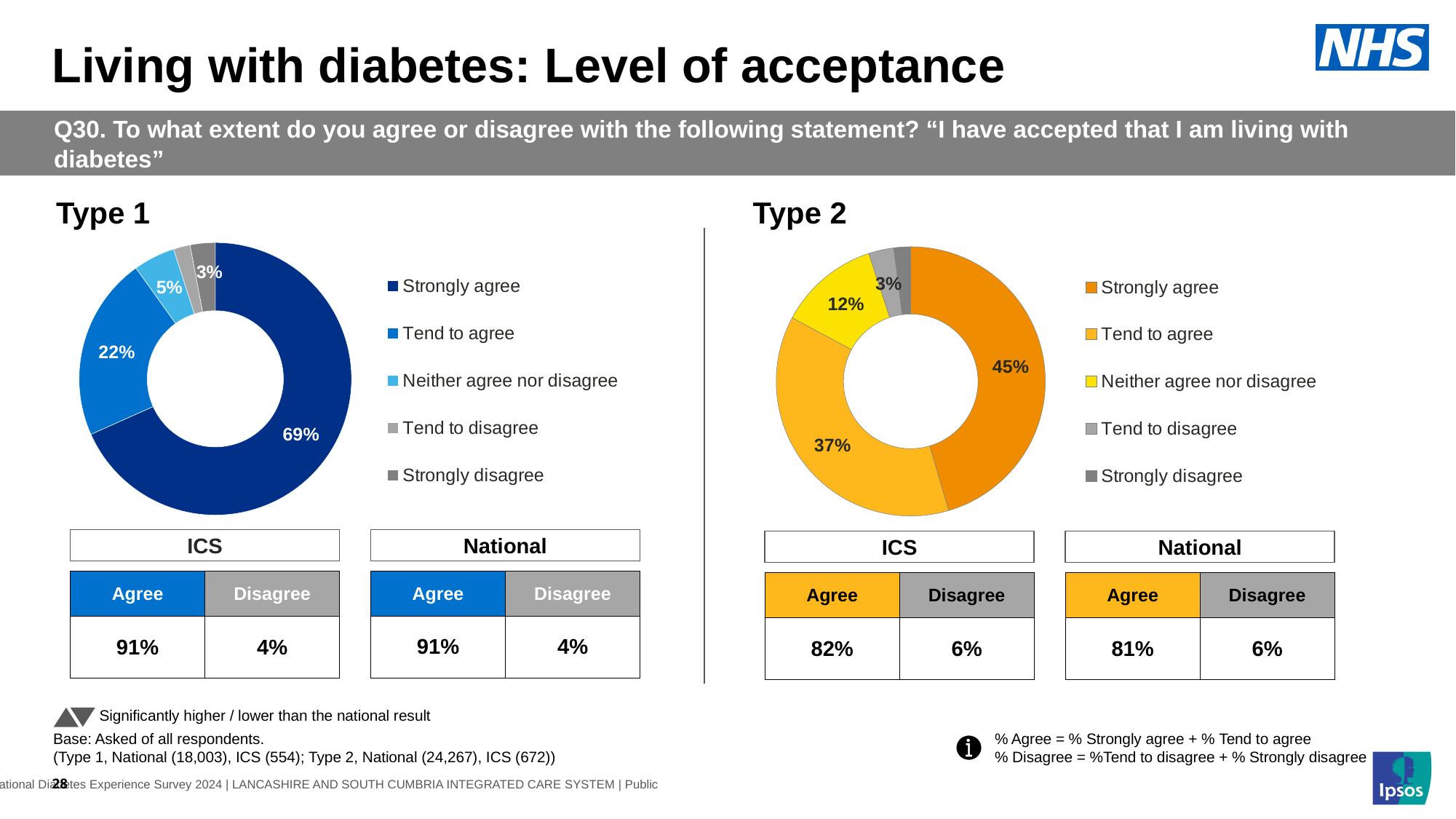
What kind of chart is used for Type 2? Donut (pie) chart In the Type 1 chart, which response category has the largest share? Strongly agree How many response categories does the legend of the Type 1 chart list? 5 In the Type 1 chart, what percentage of respondents tend to agree? 22% In the Type 2 chart, what percentage neither agree nor disagree? 12% In the Type 2 chart, what percentage of respondents tend to agree? 37% In the Type 2 chart, what is the difference in percentage points between Strongly agree and Tend to agree? 8 In the Type 2 chart, what percentage of respondents strongly agree? 45% In the Type 2 chart, which response category has the largest share? Strongly agree In the Type 1 chart, what percentage neither agree nor disagree? 5% Which is larger: the Strongly agree share in the Type 1 chart or in the Type 2 chart? Type 1 In the Type 1 chart, what percentage of respondents strongly agree? 69%